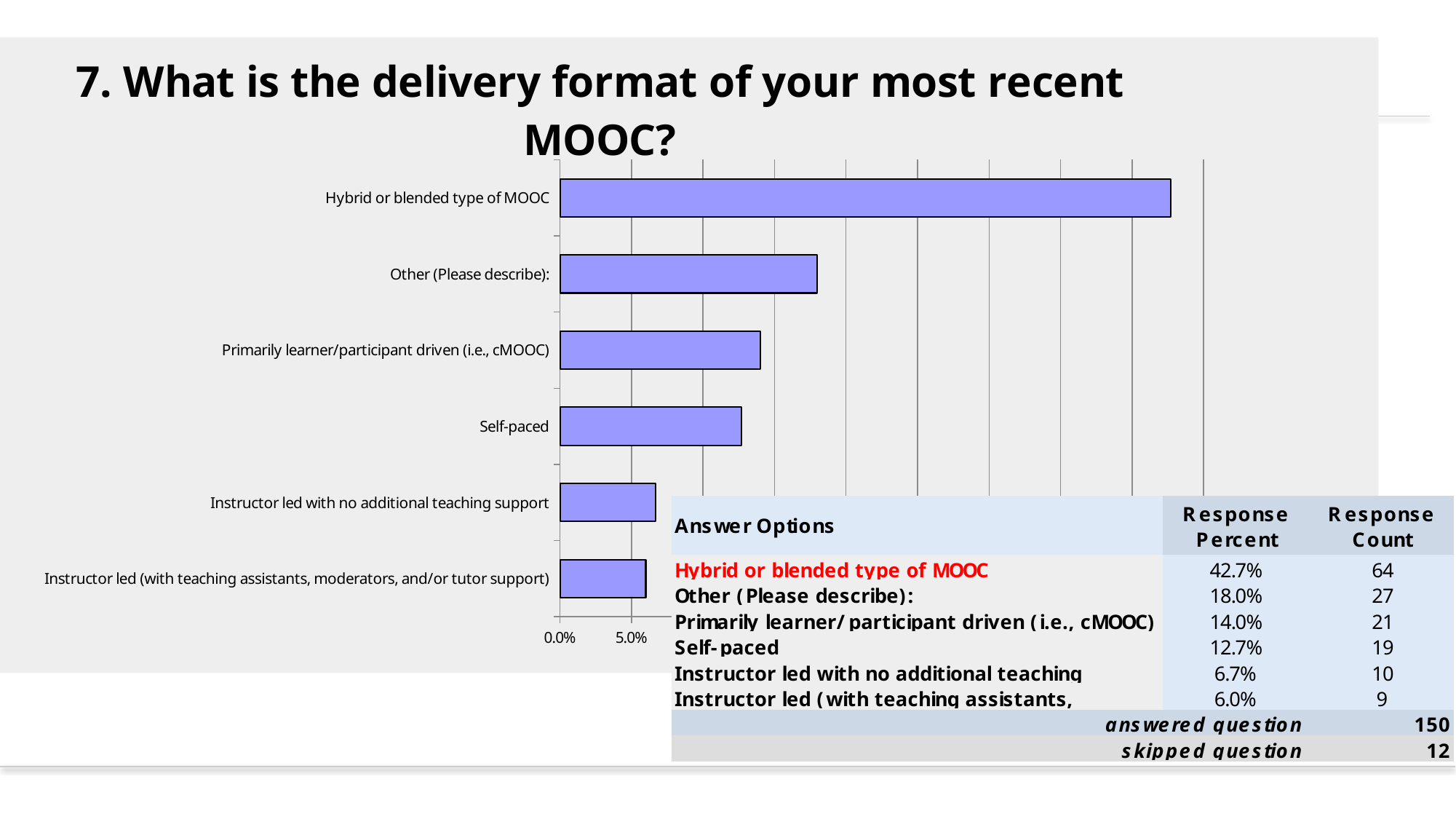
Which has a larger response percent, Self-paced or Instructor led with no additional teaching support? Self-paced What is the response percent for Self-paced? 12.7% What kind of chart is shown on the slide? bar chart How many categories does the bar chart show? 6 What is the difference in response percent between Hybrid or blended type of MOOC and Other (Please describe):? 24.7% Which category has the lowest value in the bar chart? Instructor led (with teaching assistants, moderators, and/or tutor support) What is the response percent for Hybrid or blended type of MOOC? 42.7% What is the response count for Other (Please describe):? 27 Is the value for Instructor led with no additional teaching support greater or less than 5.0%? greater What is the response percent for Primarily learner/participant driven (i.e., cMOOC)? 14.0% Which category has the highest value in the bar chart? Hybrid or blended type of MOOC How many respondents answered the question according to the table? 150